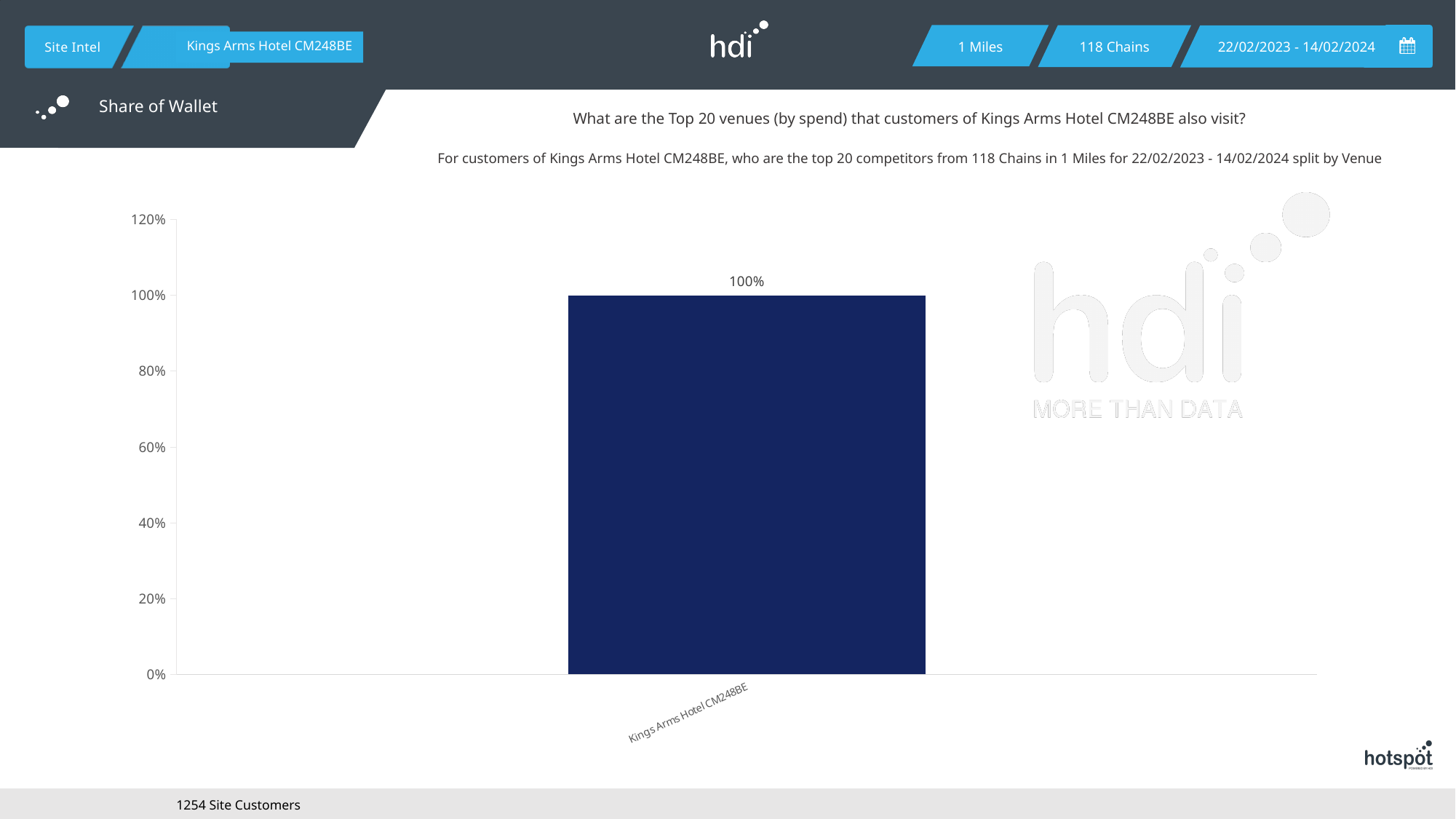
How many bars are plotted in the chart? 1 Which category has the highest value in the chart? Kings Arms Hotel CM248BE What is the value shown for Kings Arms Hotel CM248BE? 100% What is the label of the only category on the x axis? Kings Arms Hotel CM248BE What is the highest value shown on the y axis? 120% What kind of chart is shown on the slide? Bar chart Is the value for Kings Arms Hotel CM248BE greater or less than 80%? greater